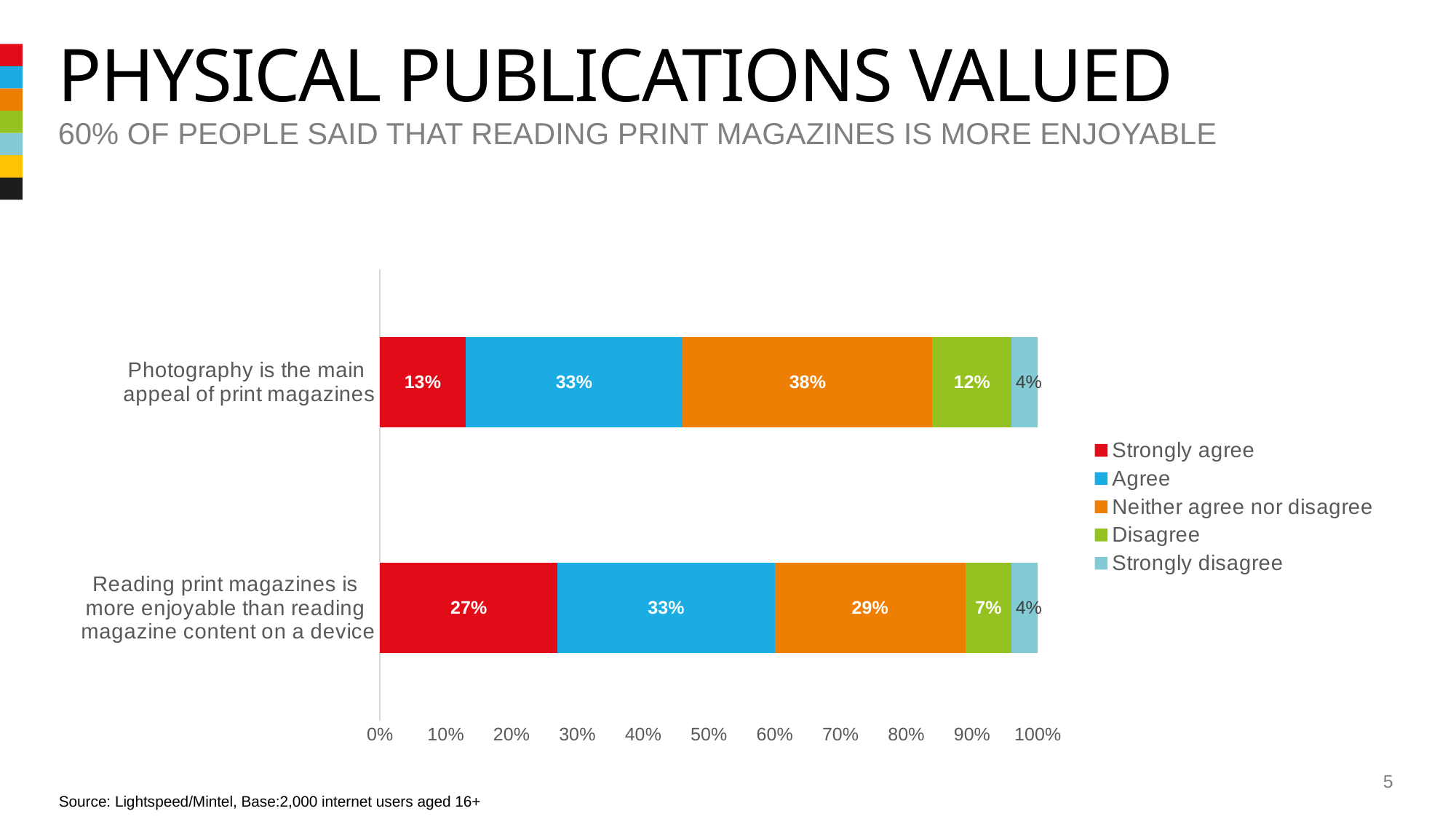
What percentage of people strongly agree that reading print magazines is more enjoyable than reading magazine content on a device? 27% What is the difference between the 'Strongly agree' percentages for the two statements? 14% What type of chart is shown on the slide? Stacked bar chart What percentage of people strongly disagree that photography is the main appeal of print magazines? 4% How many response categories does the legend list? 5 What is the combined percentage of 'Strongly agree' and 'Agree' for the statement 'Reading print magazines is more enjoyable than reading magazine content on a device'? 60% What percentage of people disagree that reading print magazines is more enjoyable than reading magazine content on a device? 7% Which statement has a larger 'Disagree' share: 'Photography is the main appeal of print magazines' or 'Reading print magazines is more enjoyable than reading magazine content on a device'? Photography is the main appeal of print magazines What percentage of people neither agree nor disagree that photography is the main appeal of print magazines? 38% Which response category has the largest share for the statement 'Photography is the main appeal of print magazines'? Neither agree nor disagree What percentage of people strongly agree that photography is the main appeal of print magazines? 13% Which response category has the smallest share for the statement 'Reading print magazines is more enjoyable than reading magazine content on a device'? Strongly disagree